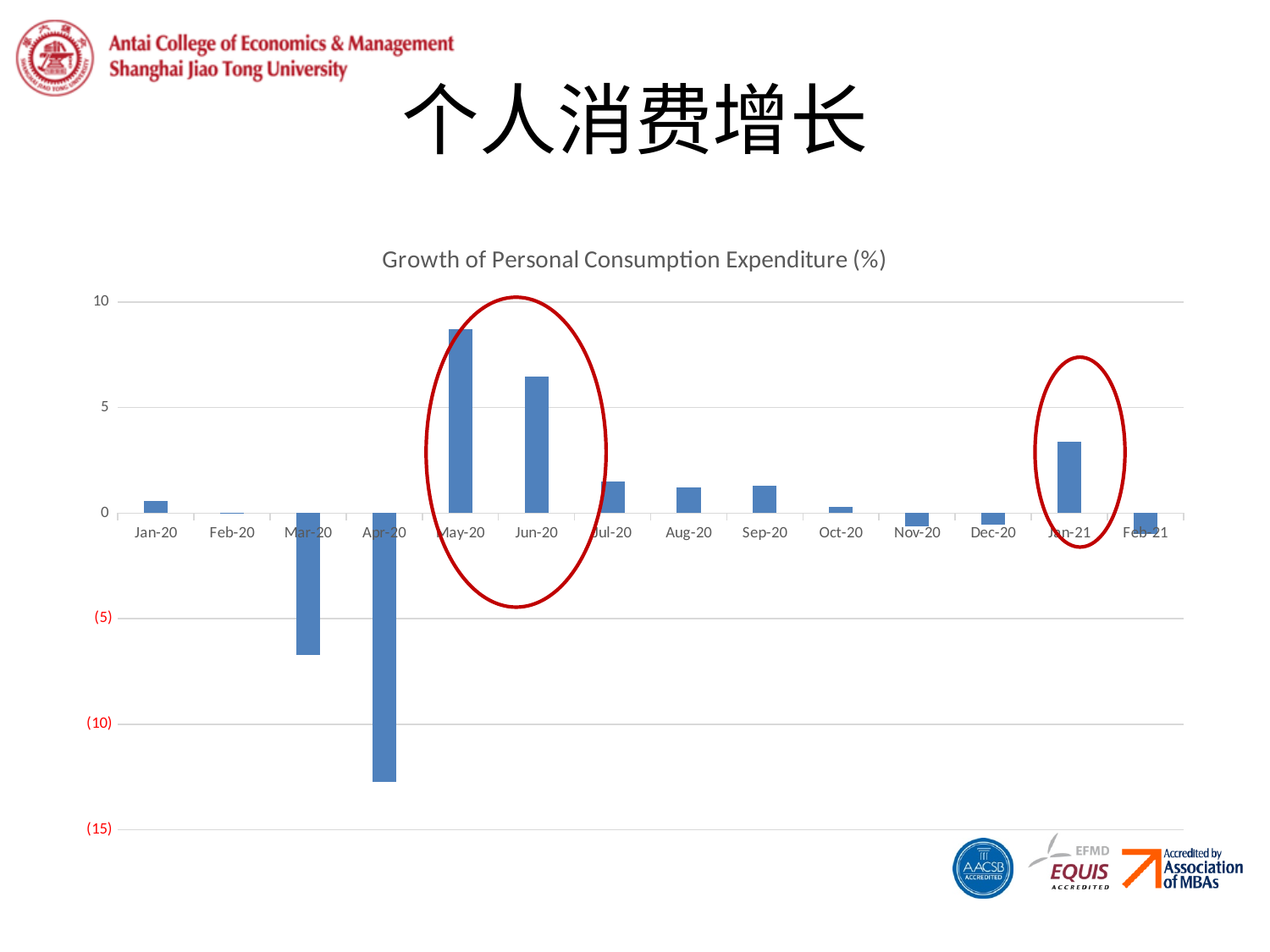
Which month has the lowest growth of personal consumption expenditure? Apr-20 Is the value for May-20 greater or less than 5? greater What is the title of the chart? Growth of Personal Consumption Expenditure (%) Which month has the highest growth of personal consumption expenditure? May-20 What kind of chart is shown on the slide? bar chart How many months are plotted on the x axis of the chart? 14 Is the value for Mar-20 greater or less than 0? less Which is larger, the value for Jan-21 or the value for Jul-20? Jan-21 Which is larger, the value for May-20 or the value for Jun-20? May-20 Is the value for Apr-20 greater or less than (10)? less